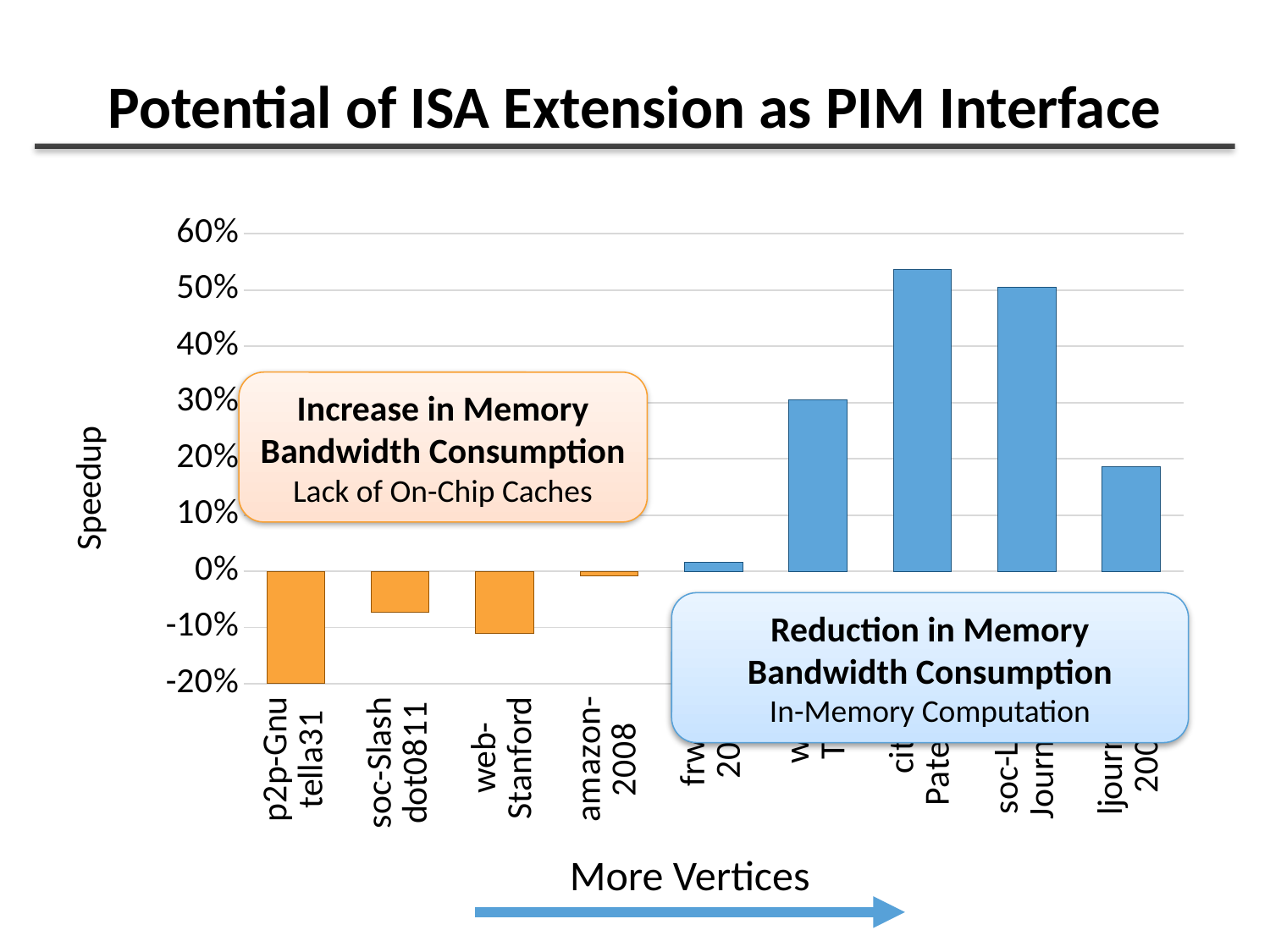
Which category has the lowest speedup? p2p-Gnutella31 How many bars in the chart are orange? 4 Is the speedup for amazon-2008 greater or less than -10%? greater Is the speedup for web-Stanford greater or less than -10%? less What is the label of the vertical axis? Speedup Is the speedup for soc-Slashdot0811 greater or less than -10%? greater What kind of chart is shown on the slide? bar chart Which has the larger speedup, p2p-Gnutella31 or amazon-2008? amazon-2008 Do the speedup values generally rise or fall moving left to right along the x axis? rise Which has the larger speedup, soc-Slashdot0811 or web-Stanford? soc-Slashdot0811 What does the arrow label below the x axis say? More Vertices How many bars (categories) are plotted in the chart? 9